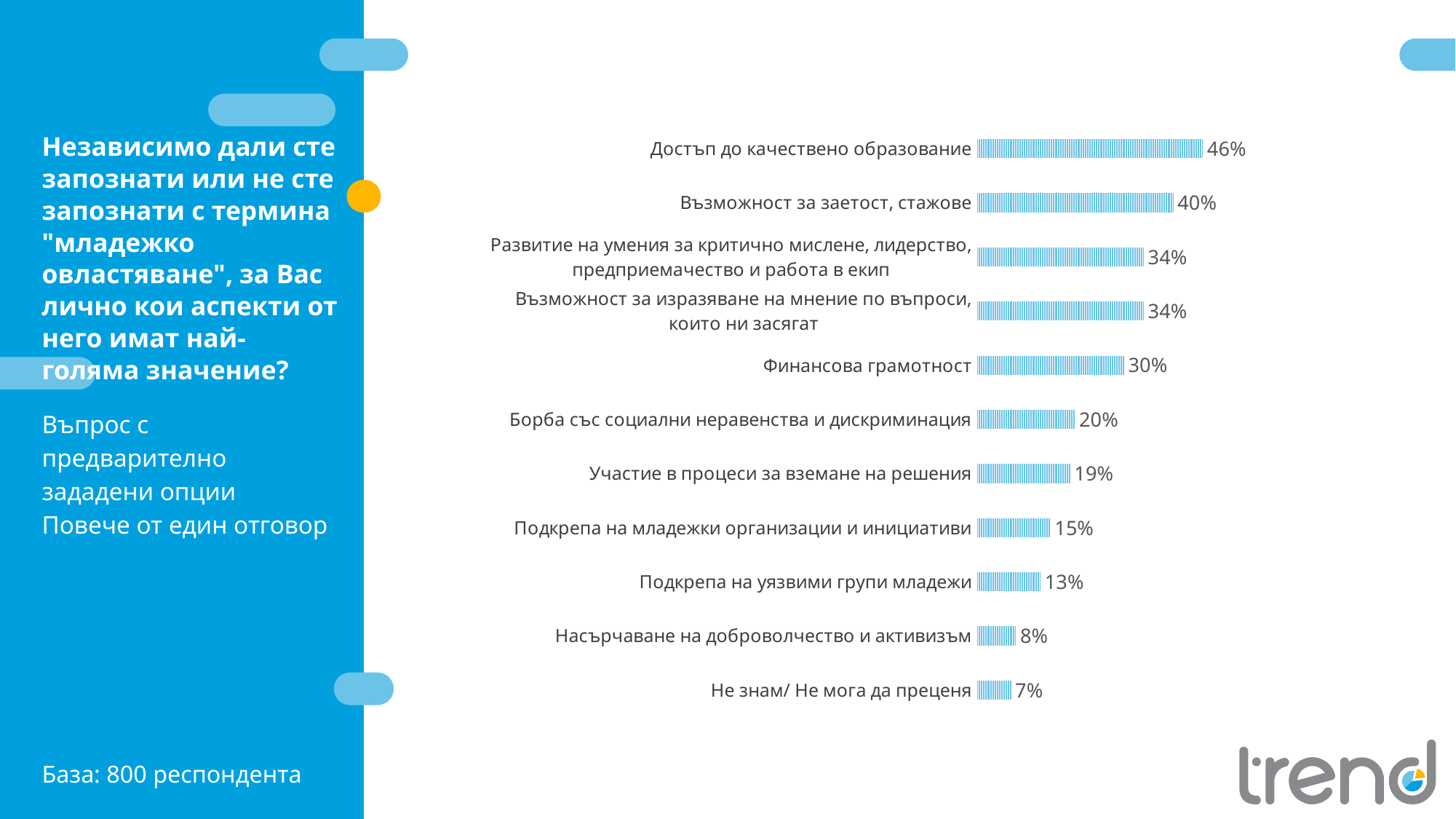
What is the value for "Финансова грамотност"? 30% How many categories are shown in the chart? 11 What is the value for "Подкрепа на уязвими групи младежи"? 13% Which is larger: "Борба със социални неравенства и дискриминация" or "Подкрепа на младежки организации и инициативи"? Борба със социални неравенства и дискриминация What is the difference between "Финансова грамотност" and "Участие в процеси за вземане на решения"? 11% What is the value for "Насърчаване на доброволчество и активизъм"? 8% How many respondents form the base of the survey shown on the slide? 800 Which category has the lowest value? Не знам/ Не мога да преценя What is the difference between "Достъп до качествено образование" and "Възможност за заетост, стажове"? 6% Which category has the highest value? Достъп до качествено образование What is the value for "Достъп до качествено образование"? 46% What kind of chart is shown on the slide? Bar chart